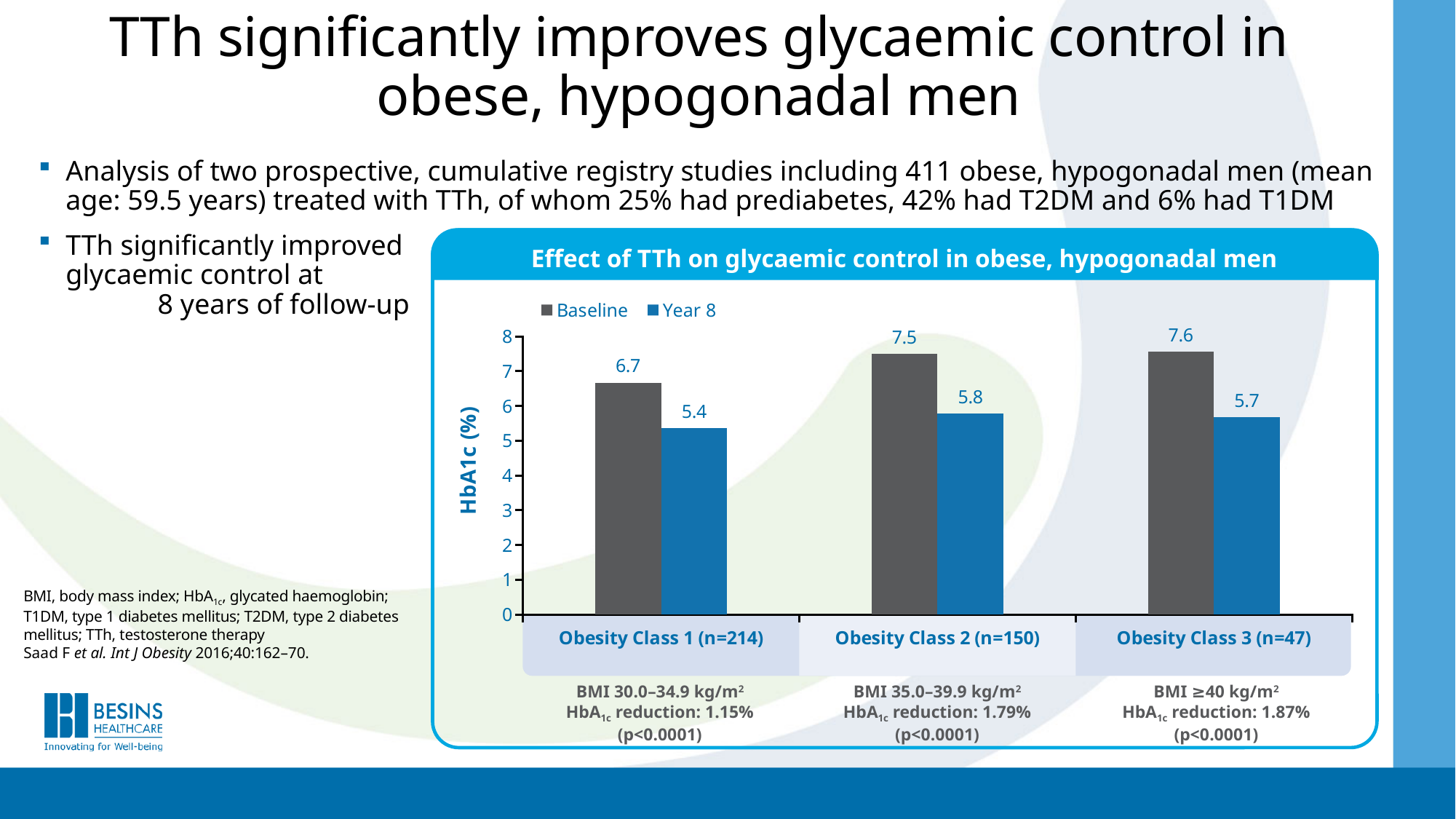
What is the difference between the Baseline and Year 8 HbA1c values for Obesity Class 2 (n=150)? 1.7 What kind of chart is shown on the slide? Bar chart Which obesity class has the highest Baseline HbA1c value? Obesity Class 3 (n=47) What is the Baseline HbA1c value for Obesity Class 1 (n=214)? 6.7 How many obesity class categories are shown on the x axis? 3 How many series does the legend list? 2 What is the Year 8 HbA1c value for Obesity Class 3 (n=47)? 5.7 Is the Baseline HbA1c value for Obesity Class 3 (n=47) greater or less than 7? greater What is the Year 8 HbA1c value for Obesity Class 2 (n=150)? 5.8 Which obesity class has the lowest Year 8 HbA1c value? Obesity Class 1 (n=214) Which is larger for Obesity Class 1 (n=214): the Baseline value or the Year 8 value? Baseline What is the title of the chart? Effect of TTh on glycaemic control in obese, hypogonadal men